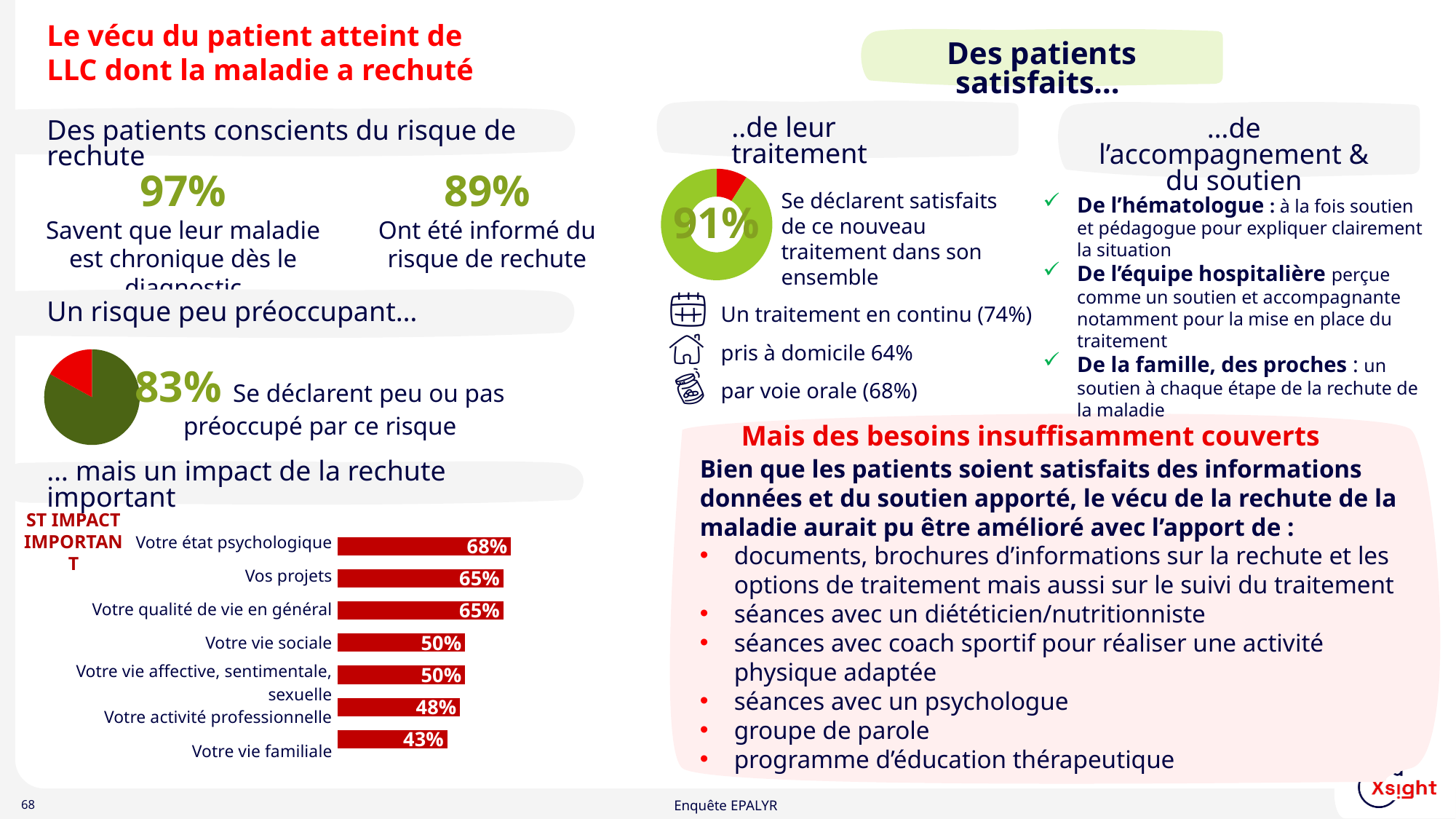
In the donut chart under "..de leur traitement", what percentage of patients declare themselves satisfied with their new treatment overall? 91% In the bar chart at the bottom left, what is the value for "Votre vie familiale"? 43% In the bar chart at the bottom left, what is the difference between the values for "Votre état psychologique" and "Votre vie familiale"? 25% How many categories does the bar chart at the bottom left show? 7 In the bar chart at the bottom left, what is the value for "Votre activité professionnelle"? 48% What kind of chart is used at the bottom left of the slide to show the impact of relapse? Bar chart In the bar chart at the bottom left, do the values rise or fall from the top category to the bottom category? Fall In the bar chart at the bottom left, what is the value for "Votre état psychologique"? 68% In the pie chart under "Un risque peu préoccupant…", what share of patients declare themselves little or not worried about the risk? 83% In the bar chart at the bottom left, which category has the highest value? Votre état psychologique In the bar chart at the bottom left, which is larger: the value for "Vos projets" or the value for "Votre vie sociale"? Vos projets In the bar chart at the bottom left, which category has the lowest value? Votre vie familiale